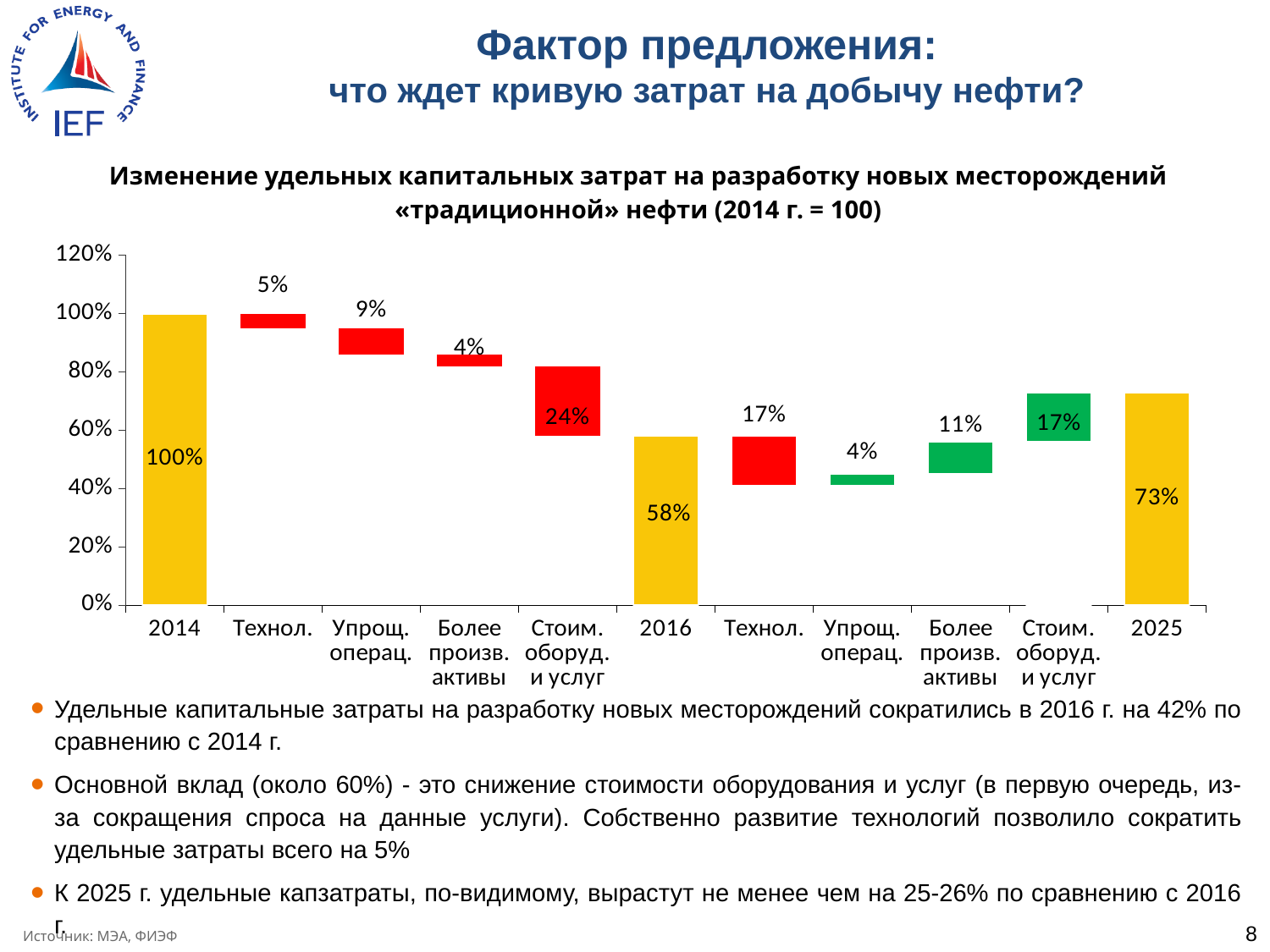
What is the value shown for 2025? 73% What is the value labelled on the 'Стоим. оборуд. и услуг' bar between 2014 and 2016? 24% What is the difference between the 2014 value and the 2016 value? 42% What is the value labelled on the 'Технол.' bar between 2016 and 2025? 17% What kind of chart is shown on the slide? Bar chart (waterfall) Which is larger, the value for 2016 or the value for 2025? 2025 Which category has the highest value in the chart? 2014 What is the difference between the 2025 value and the 2016 value? 15% What is the value shown for 2014? 100% What is the value labelled on the 'Упрощ. операц.' bar between 2014 and 2016? 9% What is the value shown for 2016? 58% How many bars are plotted in the chart? 11